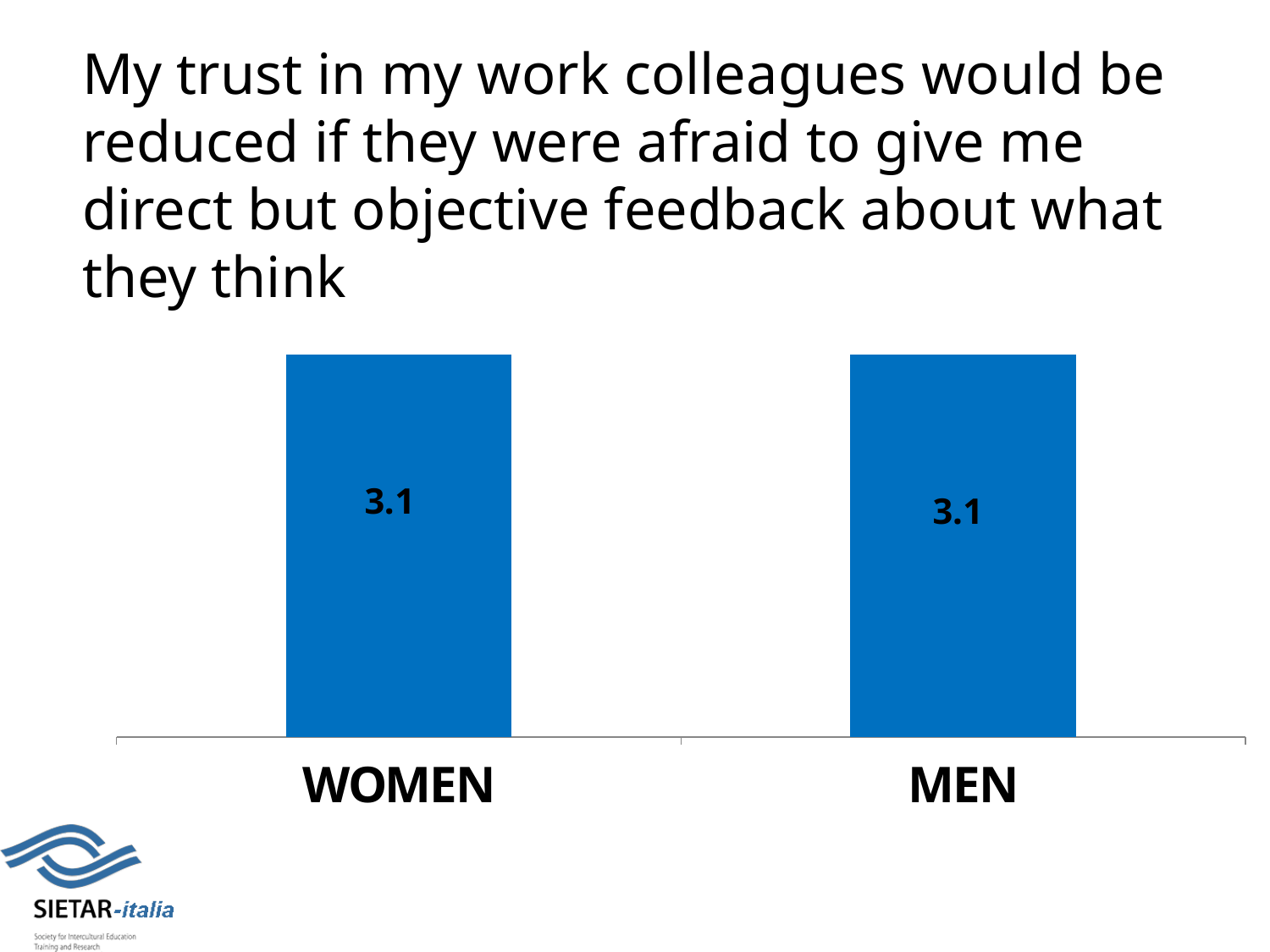
What colour are the bars in the chart? Blue Do the values for WOMEN and MEN differ? No, both are 3.1 What are the two category labels on the x axis? WOMEN and MEN What is the value for MEN? 3.1 What is the value for WOMEN? 3.1 What kind of chart is shown on the slide? bar chart How many categories are shown on the x axis? 2 What is the difference between the values for WOMEN and MEN? 0